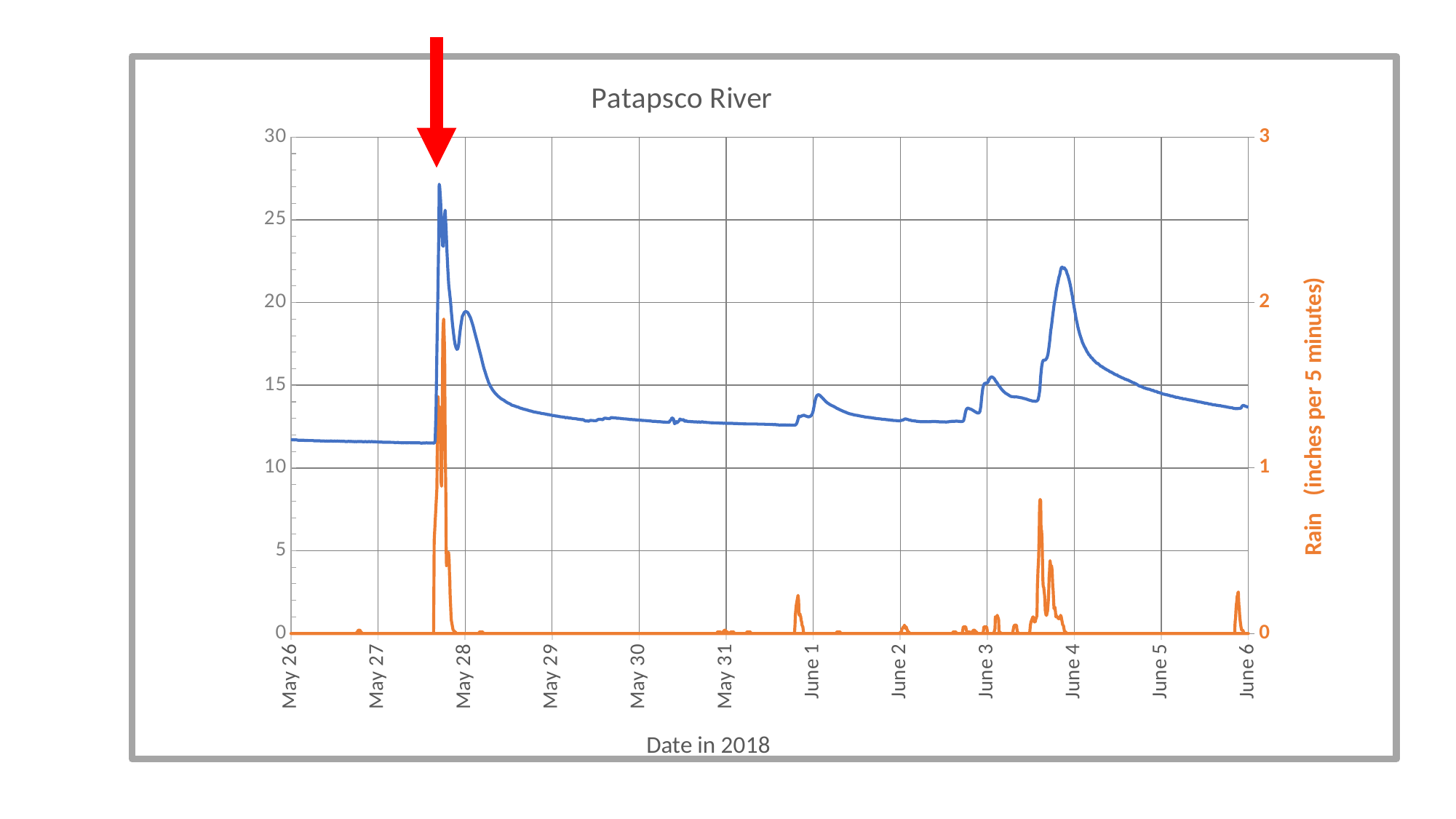
What kind of chart is shown on the slide? line chart Is the peak of the orange rain line between June 3 and June 4 greater or less than 1 on the right axis? less Around which date does the blue line reach its highest value? May 28 Is the peak of the blue line near June 4 greater or less than 20 on the left axis? greater Is the value of the blue line at May 26 greater or less than 15 on the left axis? less What is the title of the chart? Patapsco River What is the label of the right-hand vertical axis? Rain (inches per 5 minutes) Does the blue line rise or fall between May 28 and May 31? fall Which is larger: the blue line's peak near May 28 or its peak near June 4? the peak near May 28 How many date labels are shown along the x axis? 12